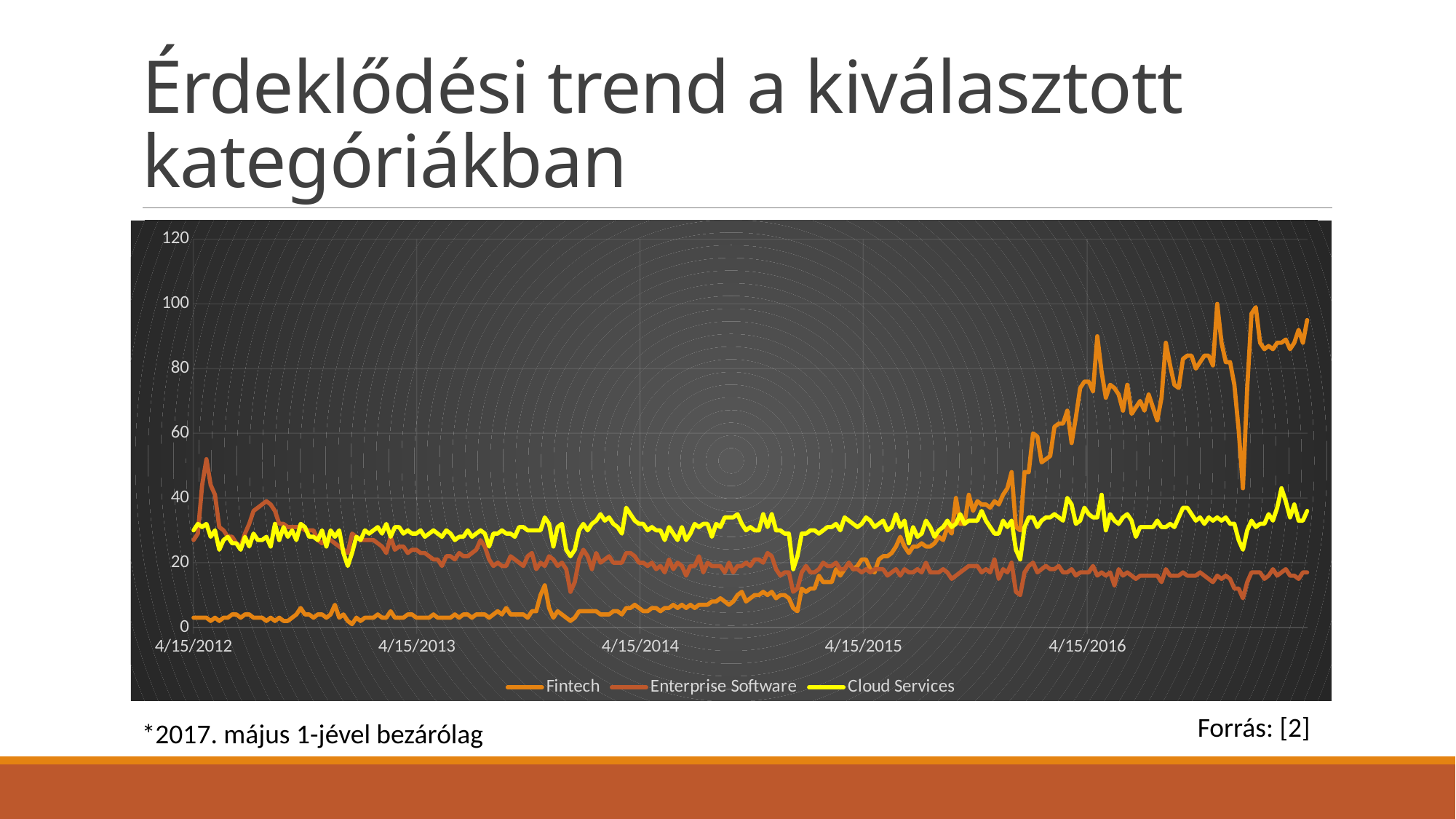
Does the Enterprise Software series rise or fall overall from 4/15/2012 to the end of the chart? fall At 4/15/2014, which series has the higher value, Cloud Services or Fintech? Cloud Services What is the highest value shown on the chart's vertical axis? 120 Which series are listed in the chart's legend? Fintech, Enterprise Software, Cloud Services Does the Fintech series rise or fall overall from 4/15/2012 to the end of the chart? rise Which series has the highest value at the right end of the chart? Fintech Is the Fintech value at 4/15/2016 greater or less than 40? greater What kind of chart is shown on the slide? line chart Is the Enterprise Software value at 4/15/2016 greater or less than 40? less How many series does the chart's legend list? 3 Which series has the lowest value at 4/15/2013? Fintech Is the Fintech value at 4/15/2013 greater or less than 20? less